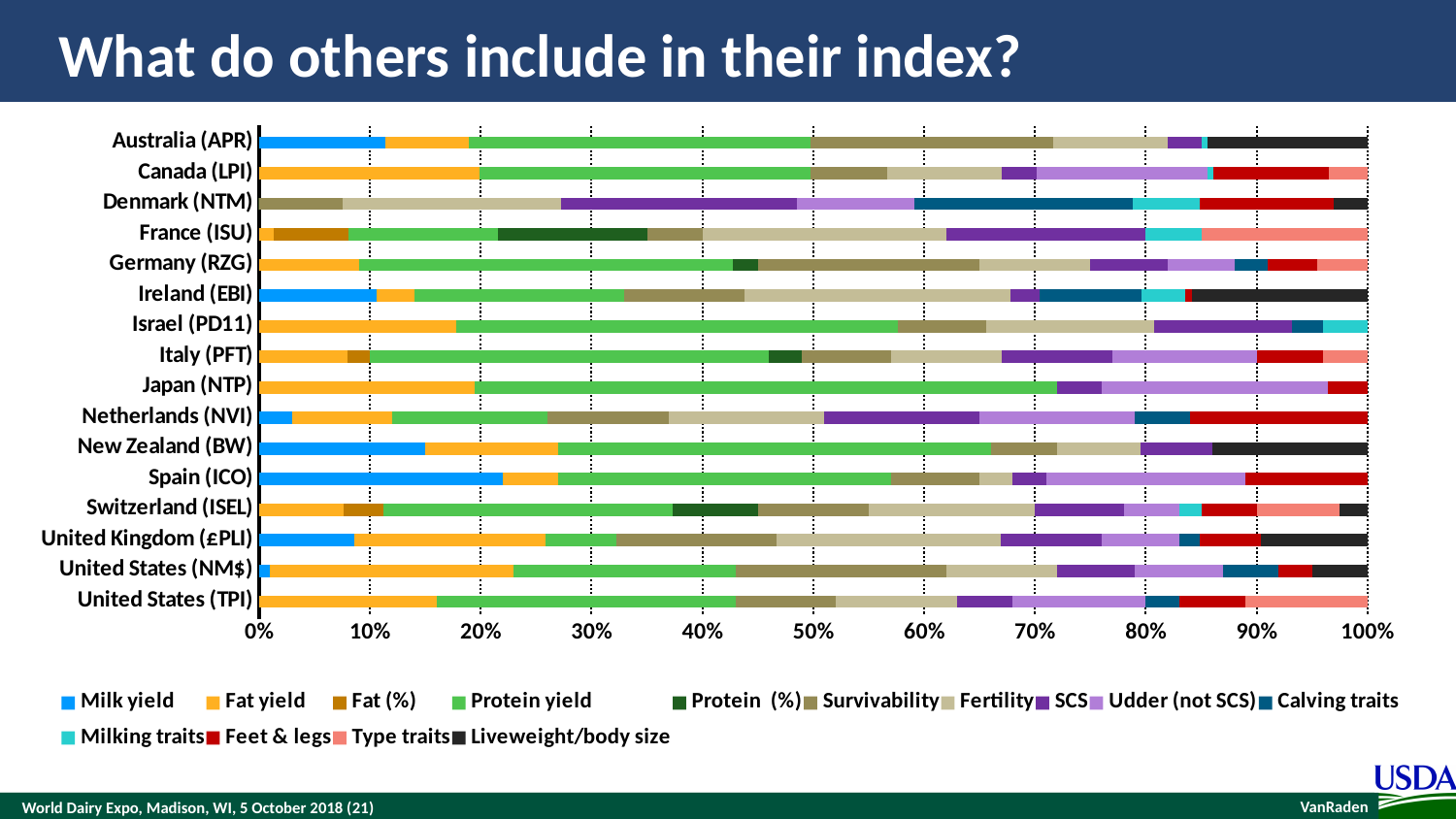
How many indexes (categories) are listed on the vertical axis of the chart? 16 Which index has the largest Protein yield share, Japan (NTP) or Netherlands (NVI)? Japan (NTP) Which index has the largest Protein yield share in the chart? Japan (NTP) Which index has the largest Milk yield share, Spain (ICO) or Netherlands (NVI)? Spain (ICO) What is the title of the slide containing the chart? What do others include in their index? Is the Protein yield share for Japan (NTP) greater or less than 40%? greater How many series does the chart legend list? 14 What does each full bar in the chart add up to? 100% Is the Milk yield share for Netherlands (NVI) greater or less than 10%? less Which colour represents Milk yield in the chart legend? Blue Is the Milk yield share for Spain (ICO) greater or less than 10%? greater What kind of chart is shown on the slide? Stacked bar chart